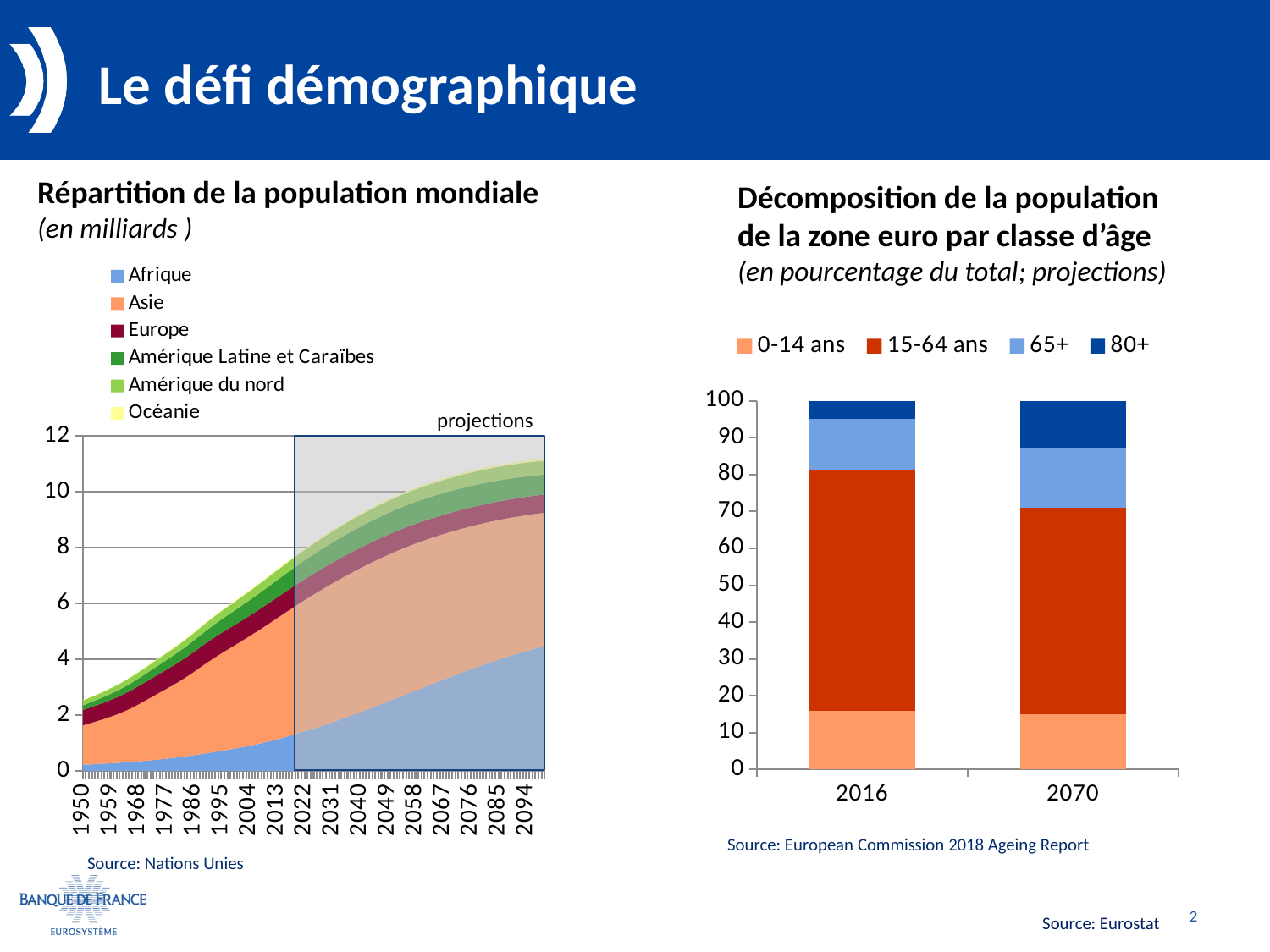
In the left chart, 'Répartition de la population mondiale', from which year does the shaded 'projections' area begin? 2022 In the right chart, 'Décomposition de la population de la zone euro par classe d'âge', is the 15-64 ans share in 2016 greater or less than 60? greater How many series does the legend of the left chart, 'Répartition de la population mondiale', list? 6 What kind of chart is the right chart, 'Décomposition de la population de la zone euro par classe d'âge'? stacked bar chart How many series does the legend of the right chart, 'Décomposition de la population de la zone euro par classe d'âge', list? 4 In the left chart, 'Répartition de la population mondiale', is the total world population in 1950 greater or less than 4 billion? less In the right chart, 'Décomposition de la population de la zone euro par classe d'âge', is the share of the 15-64 ans group larger in 2016 or in 2070? 2016 In the right chart, 'Décomposition de la population de la zone euro par classe d'âge', is the share of the 80+ group larger in 2016 or in 2070? 2070 What kind of chart is the left chart, 'Répartition de la population mondiale'? stacked area chart In the left chart, 'Répartition de la population mondiale', is the total world population in 2094 greater or less than 10 billion? greater How many years (categories) are shown on the x axis of the right chart, 'Décomposition de la population de la zone euro par classe d'âge'? 2 In the left chart, 'Répartition de la population mondiale', does the total world population rise or fall from 1950 to 2094? rise